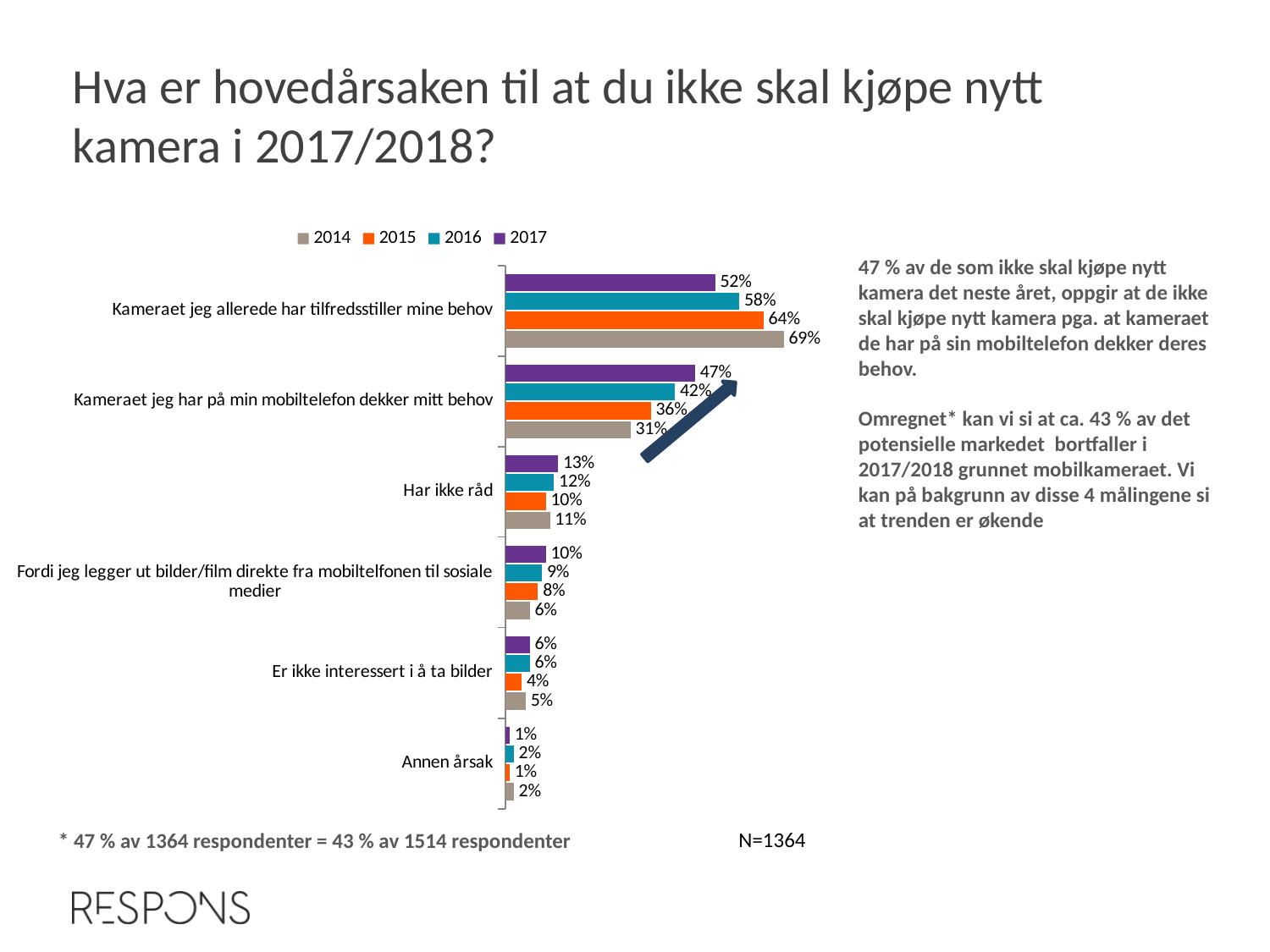
What is the difference between the 2014 and 2017 values for "Kameraet jeg allerede har tilfredsstiller mine behov"? 17% What kind of chart is shown on the slide? bar chart Which category has the lowest 2016 value? Annen årsak How many series does the legend list? 4 Which is larger for "Kameraet jeg har på min mobiltelefon dekker mitt behov": the 2014 value or the 2017 value? 2017 Which colour represents the 2017 series in the legend? purple Do the values for "Kameraet jeg har på min mobiltelefon dekker mitt behov" rise or fall from 2014 to 2017? rise What is the 2015 value for "Har ikke råd"? 10% What is the 2014 value for "Kameraet jeg allerede har tilfredsstiller mine behov"? 69% How many categories (reasons) are shown on the chart? 6 What is the 2017 value for "Kameraet jeg har på min mobiltelefon dekker mitt behov"? 47% Which category has the highest 2017 value? Kameraet jeg allerede har tilfredsstiller mine behov